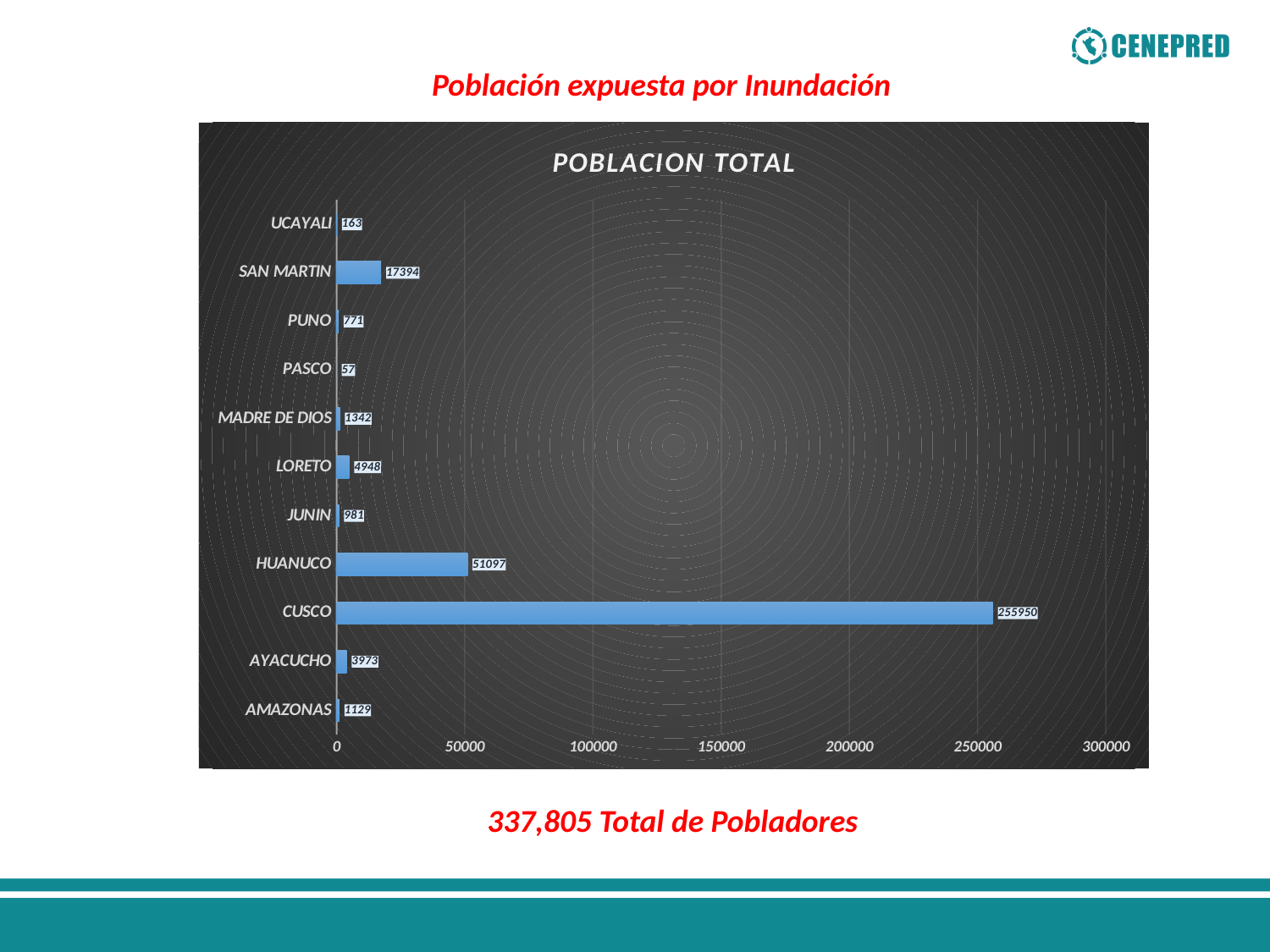
What is the value for MADRE DE DIOS? 1342 Which category has the lowest value? PASCO What is the value for SAN MARTIN? 17394 Which is larger, the value for LORETO or the value for AYACUCHO? LORETO What is the title of the chart? POBLACION TOTAL Is the value for HUANUCO greater or less than 100000? less What is the difference between the values for CUSCO and HUANUCO? 204853 How many categories are shown in the chart? 11 What kind of chart is shown on the slide? bar chart What is the difference between the values for SAN MARTIN and LORETO? 12446 What is the value for CUSCO? 255950 Which category has the highest value? CUSCO